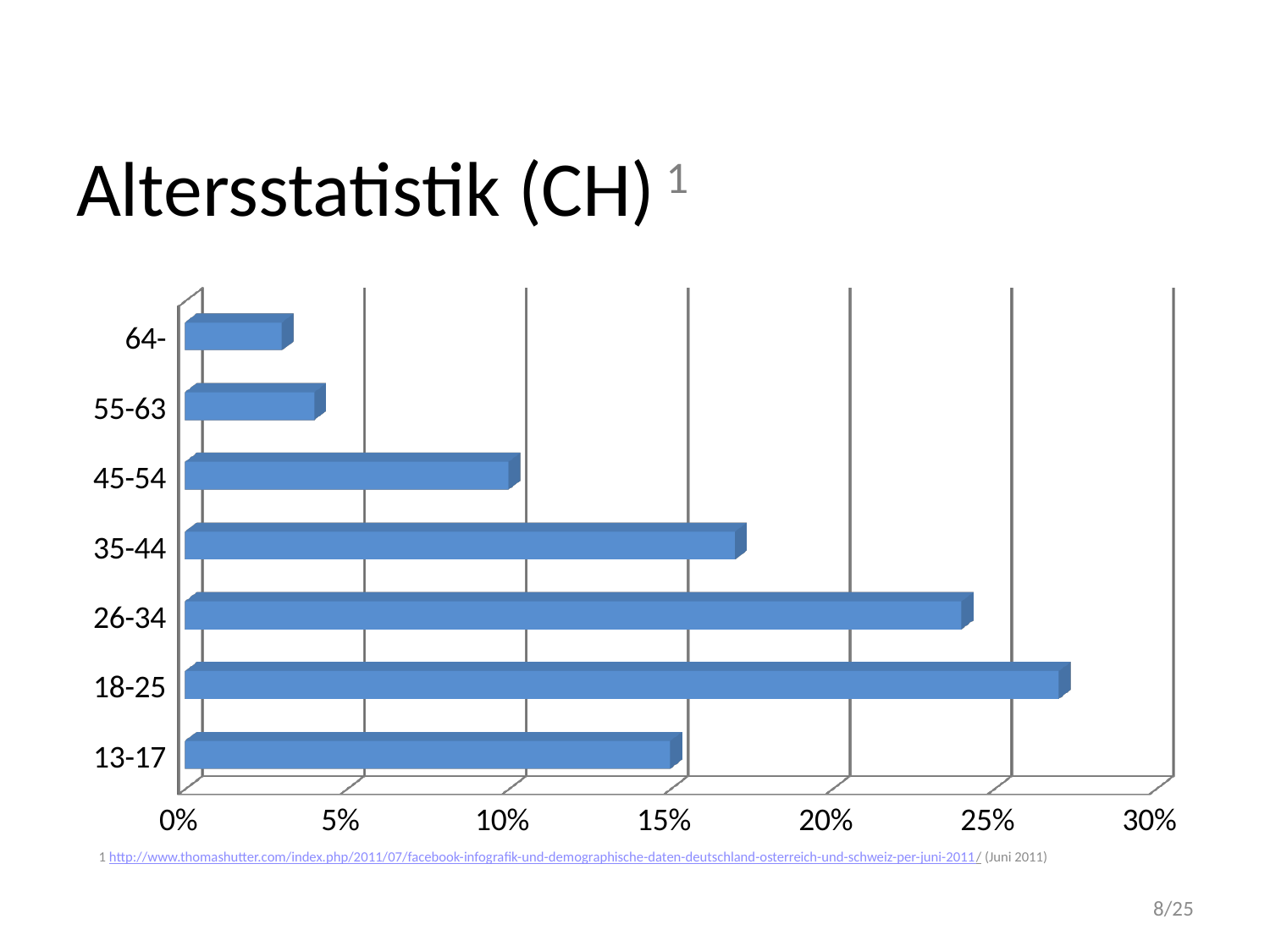
How many age categories are plotted in the chart? 7 Is the value for 45-54 greater or less than 15%? less Is the value for 64- greater or less than 5%? less Which age category has the lowest value? 64- Is the value for 26-34 greater or less than 20%? greater Which age category has the highest value? 18-25 What is the title of the slide containing the chart? Altersstatistik (CH) What kind of chart is shown on the slide? bar chart Which has the larger value, 13-17 or 45-54? 13-17 Which has the larger value, 26-34 or 35-44? 26-34